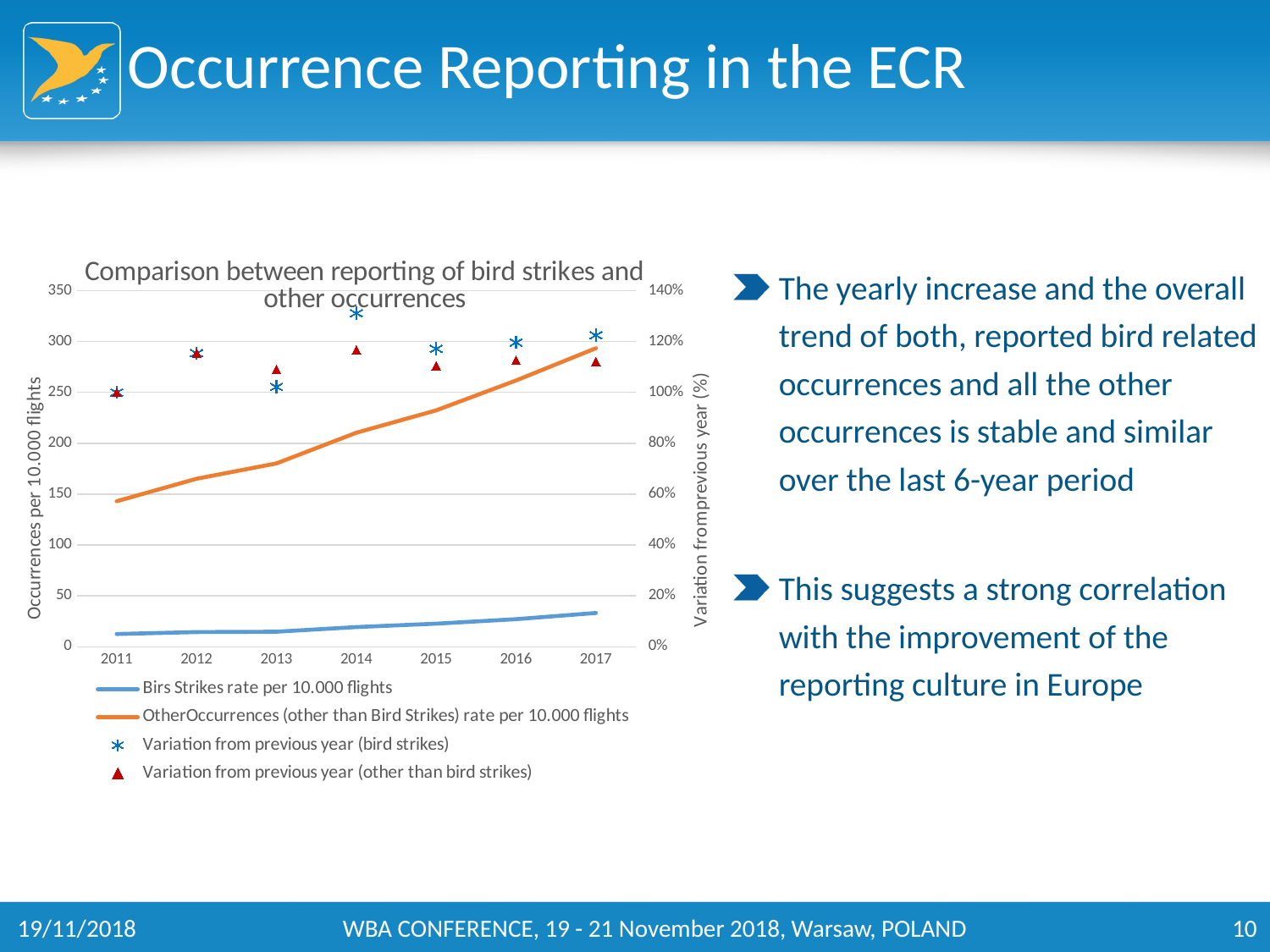
Is the 'OtherOccurrences (other than Bird Strikes) rate per 10.000 flights' value for 2017 greater or less than 250? greater What kind of chart is shown on the slide? line chart In 2015, which is larger: the 'Birs Strikes rate per 10.000 flights' or the 'OtherOccurrences (other than Bird Strikes) rate per 10.000 flights'? OtherOccurrences (other than Bird Strikes) rate per 10.000 flights How many series does the chart's legend list? 4 In which year is the 'OtherOccurrences (other than Bird Strikes) rate per 10.000 flights' highest? 2017 In which year is the 'Birs Strikes rate per 10.000 flights' lowest? 2011 Does the 'OtherOccurrences (other than Bird Strikes) rate per 10.000 flights' line rise or fall from 2011 to 2017? rise What is the label of the right-hand vertical axis of the chart? Variation fromprevious year (%) Is the 'Birs Strikes rate per 10.000 flights' value for 2017 greater or less than 50? less What is the title of the chart? Comparison between reporting of bird strikes and other occurrences How many years are plotted along the x axis of the chart? 7 Is the 'Variation from previous year (bird strikes)' value for 2014 greater or less than 120%? greater